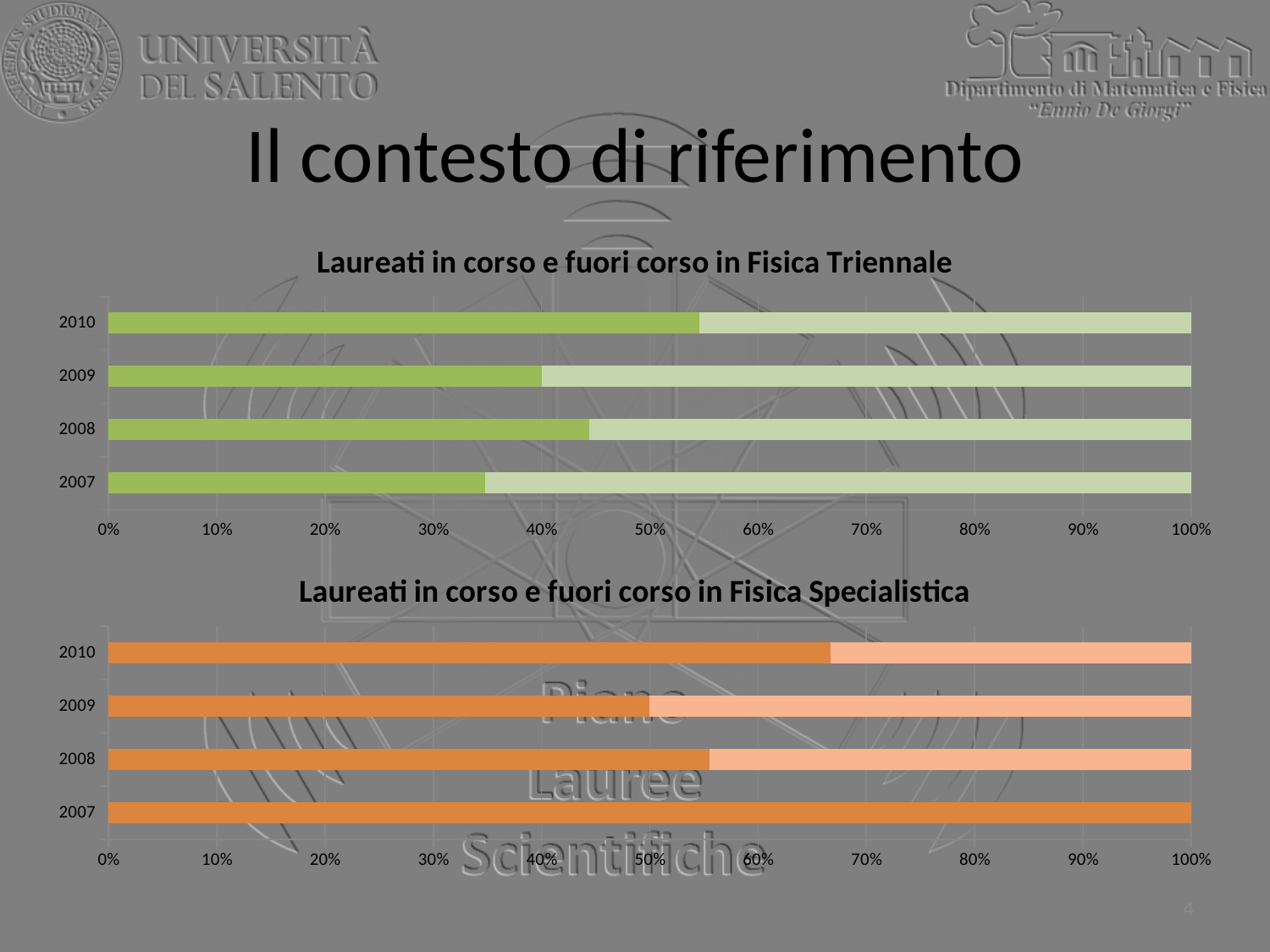
In the bottom chart (Fisica Specialistica), which year has the longest dark orange segment? 2007 In the top chart (Fisica Triennale), which year has the shortest dark green segment? 2007 In the bottom chart (Fisica Specialistica), is the dark orange segment larger for 2010 or for 2009? 2010 In the top chart (Fisica Triennale), which year has the longest dark green segment? 2010 In the top chart (Fisica Triennale), is the dark green segment for 2007 greater or less than 40%? less In the bottom chart (Fisica Specialistica), what value does the dark orange segment for 2007 reach on the axis? 100% In the top chart (Fisica Triennale), is the dark green segment for 2008 greater or less than 50%? less In the bottom chart (Fisica Specialistica), is the dark orange segment for 2010 greater or less than 60%? greater What is the title of the top chart on the slide? Laureati in corso e fuori corso in Fisica Triennale What kind of chart is the top chart, 'Laureati in corso e fuori corso in Fisica Triennale'? bar chart How many years are shown on the bottom chart, 'Laureati in corso e fuori corso in Fisica Specialistica'? 4